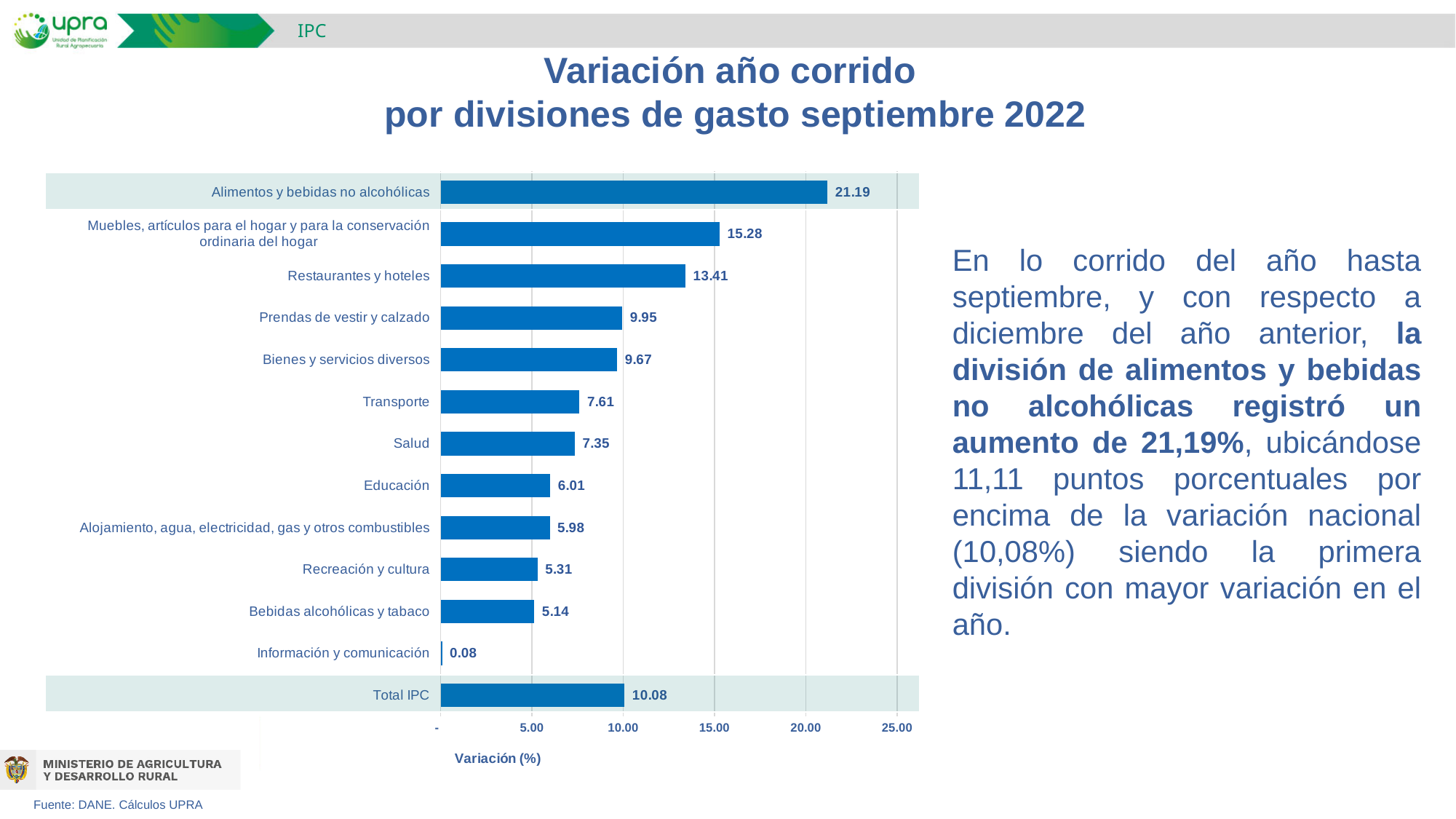
Is the value for Restaurantes y hoteles greater or less than 10.00? greater What is the value for Total IPC? 10.08 Which is larger, the value for Salud or the value for Educación? Salud What is the value for Alimentos y bebidas no alcohólicas? 21.19 What is the label of the x axis? Variación (%) Which category has the highest value? Alimentos y bebidas no alcohólicas What is the difference between the values for Muebles, artículos para el hogar y para la conservación ordinaria del hogar and Restaurantes y hoteles? 1.87 Which category has the lowest value? Información y comunicación What is the difference between the values for Alimentos y bebidas no alcohólicas and Total IPC? 11.11 How many categories are shown in the chart? 13 What is the value for Transporte? 7.61 What kind of chart is shown on the slide? bar chart